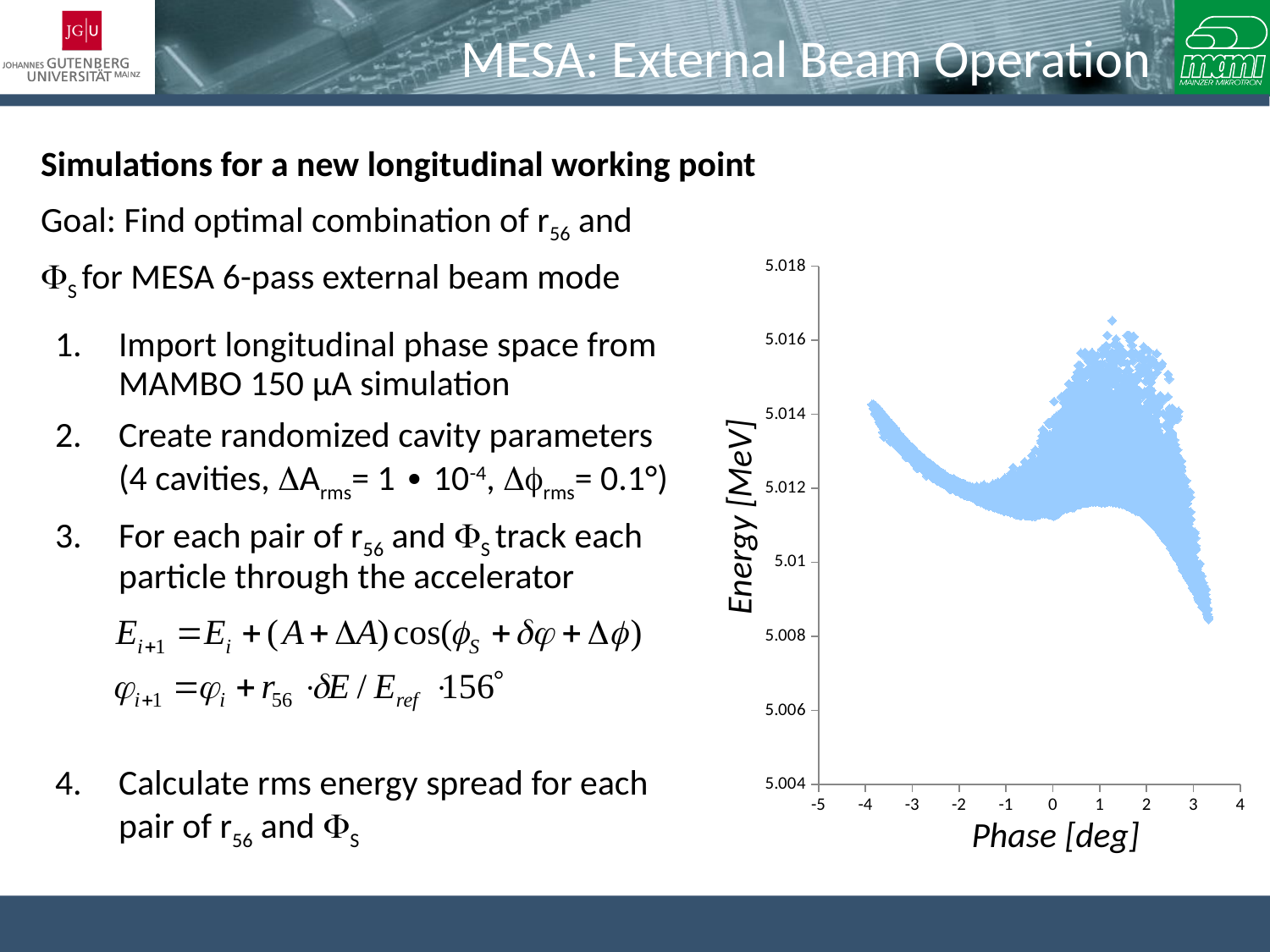
Between phase 2 and phase 3, does the energy of the point cloud rise or fall as phase increases? fall What is the label of the y axis of the chart? Energy [MeV] Is the smallest phase value covered by the scattered points greater or less than -3? less What kind of chart is shown on the right side of the slide? scatter chart What is the label of the x axis of the chart? Phase [deg] Between phase 0 and phase 1, does the energy of the point cloud rise or fall as phase increases? rise Is the highest energy value reached by the scattered points greater or less than 5.014? greater Is the largest phase value covered by the scattered points greater or less than 3? greater Between phase -4 and phase -1, does the energy of the point cloud rise or fall as phase increases? fall